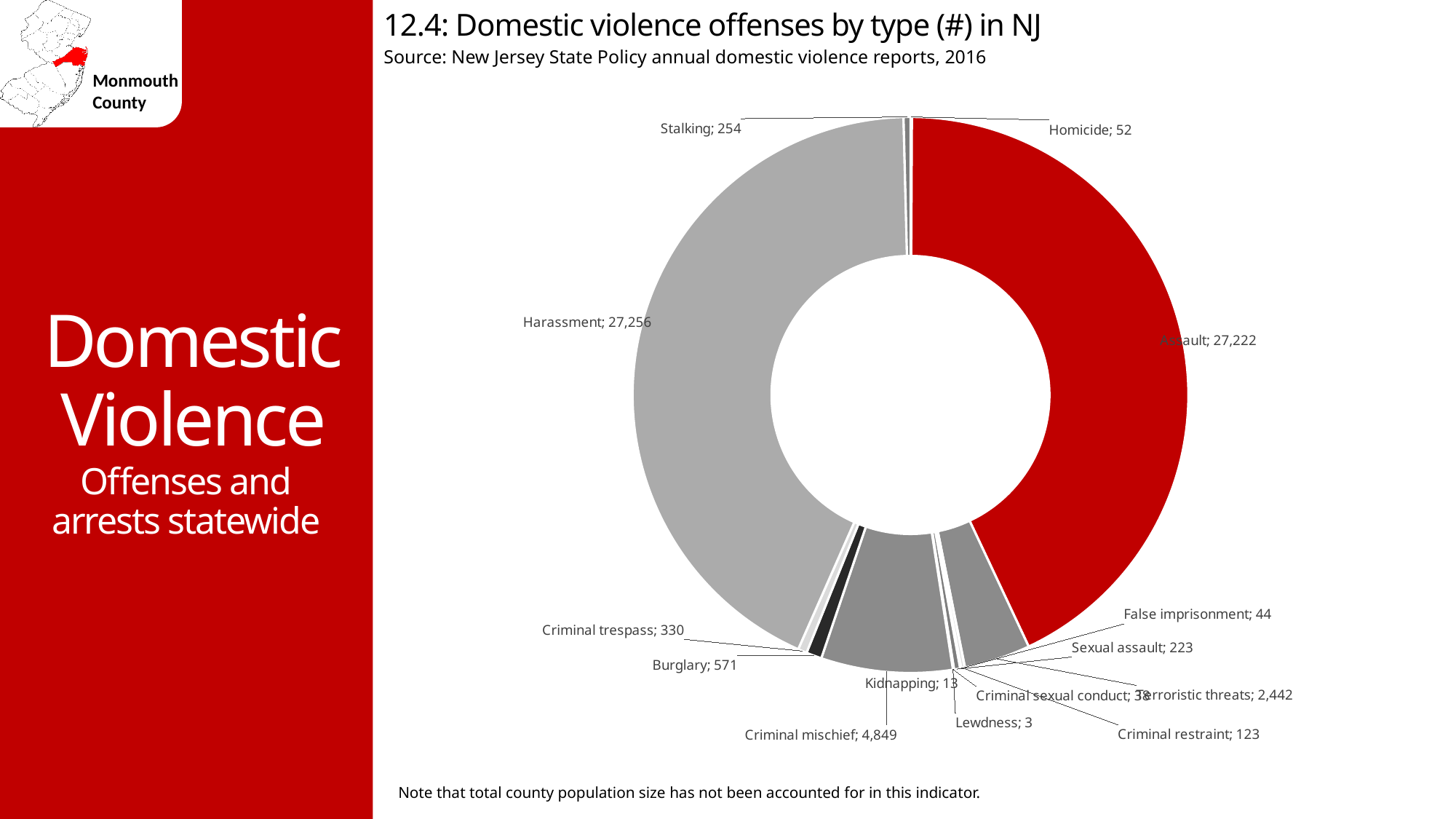
How many Terroristic threats offenses are shown? 2,442 What is the value for Criminal mischief? 4,849 What kind of chart is shown on the slide? doughnut chart How many offense types are shown on the chart? 14 What is the difference between the Harassment and Assault values? 34 Which is larger, Criminal mischief or Terroristic threats? Criminal mischief How much larger is the Burglary value than the Criminal trespass value? 241 What is the value for Burglary? 571 What is the value for Stalking? 254 What colour is the Assault slice of the chart? red What is the number of Assault offenses shown on the chart? 27,222 Which offense type has the lowest value on the chart? Lewdness